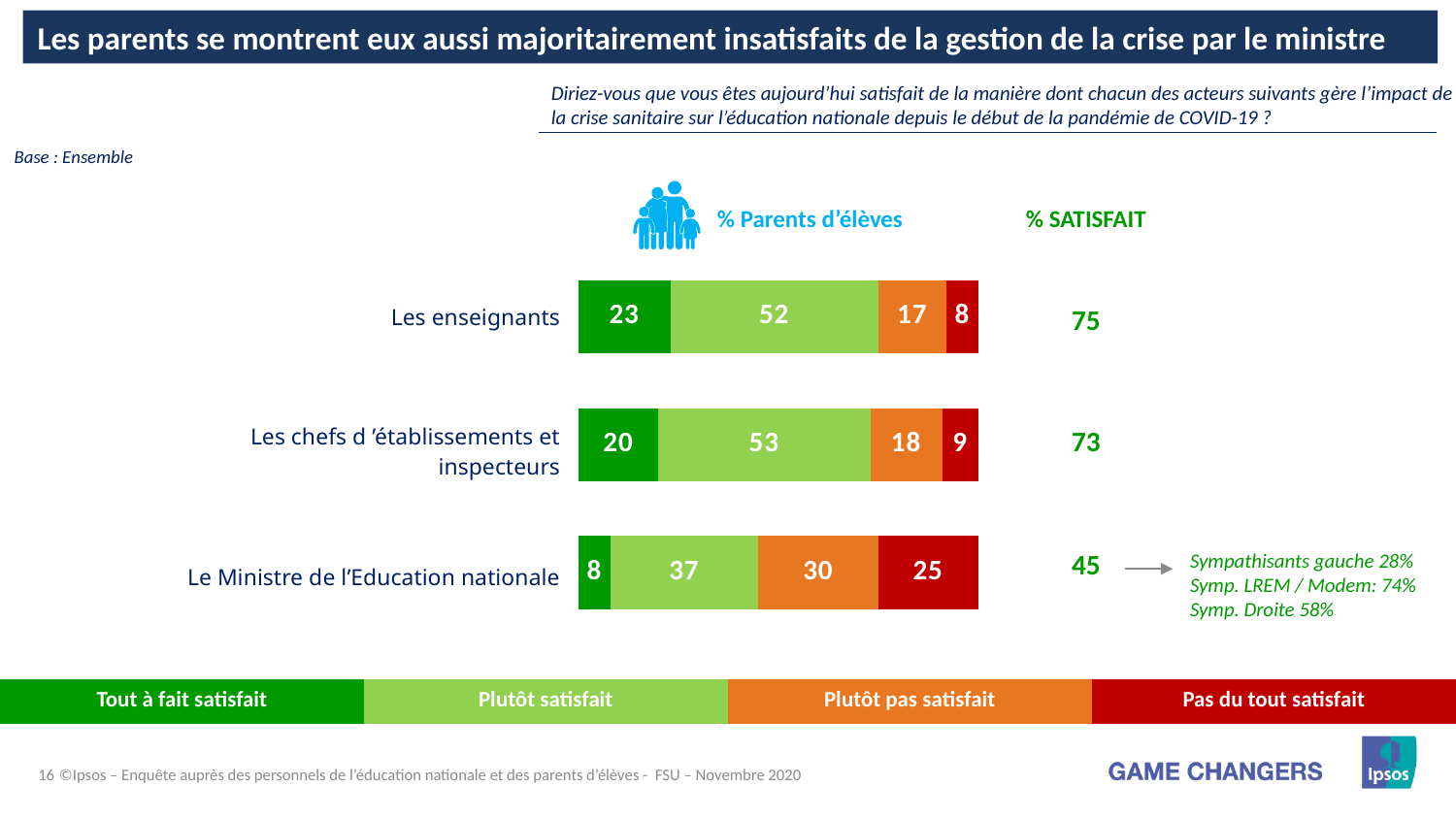
What is the % SATISFAIT figure shown for Le Ministre de l'Education nationale? 45 What is the total of the 'Tout à fait satisfait' and 'Plutôt satisfait' segments for Les chefs d'établissements et inspecteurs? 73 What is the 'Pas du tout satisfait' value for Le Ministre de l'Education nationale? 25 What is the difference between the % SATISFAIT for Les enseignants and for Le Ministre de l'Education nationale? 30 Which category has the lowest 'Tout à fait satisfait' value? Le Ministre de l'Education nationale How many series does the legend list? 4 What is the 'Tout à fait satisfait' value for Les enseignants? 23 How many categories (actors) are shown in the chart? 3 What kind of chart is shown on the slide? Stacked bar chart What is the 'Plutôt satisfait' value for Les chefs d'établissements et inspecteurs? 53 Which category has the highest 'Plutôt pas satisfait' value? Le Ministre de l'Education nationale Which is larger: the 'Plutôt satisfait' value for Les enseignants or for Le Ministre de l'Education nationale? Les enseignants